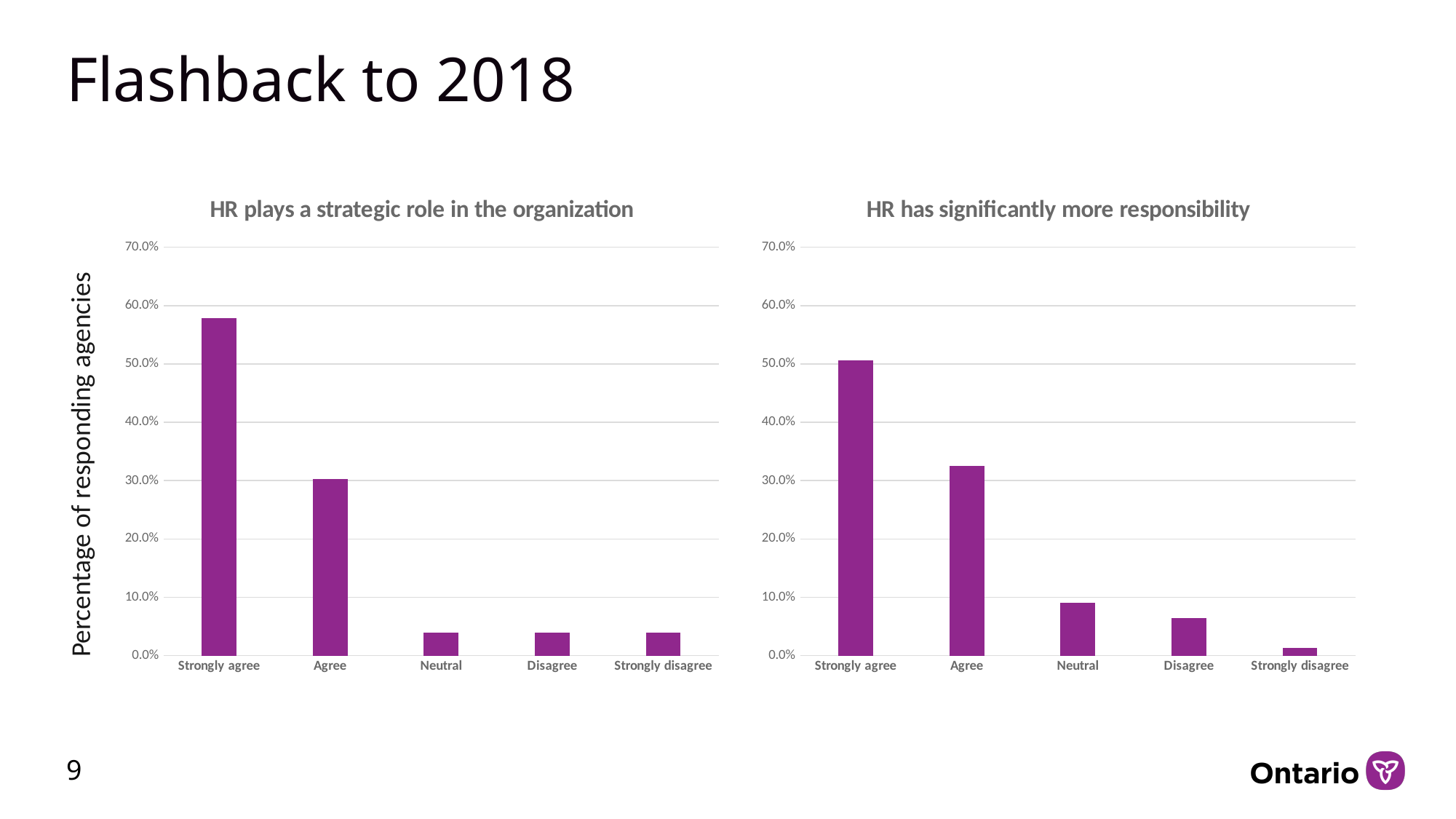
In the chart titled "HR has significantly more responsibility", which category has the highest value? Strongly agree What kind of chart is the chart titled "HR plays a strategic role in the organization"? bar chart In the chart titled "HR has significantly more responsibility", which category has the lowest value? Strongly disagree How many categories are shown on the x axis of the chart titled "HR has significantly more responsibility"? 5 In the chart titled "HR has significantly more responsibility", is the value for Agree greater or less than 30.0%? greater In the chart titled "HR has significantly more responsibility", which is larger, the value for Neutral or the value for Disagree? Neutral In the chart titled "HR plays a strategic role in the organization", is the value for Agree greater or less than 40.0%? less In the chart titled "HR plays a strategic role in the organization", which category has the highest value? Strongly agree In the chart titled "HR plays a strategic role in the organization", which is larger, the value for Strongly agree or the value for Agree? Strongly agree In the chart titled "HR plays a strategic role in the organization", is the value for Strongly agree greater or less than 50.0%? greater What is the label on the vertical axis to the left of the chart titled "HR plays a strategic role in the organization"? Percentage of responding agencies